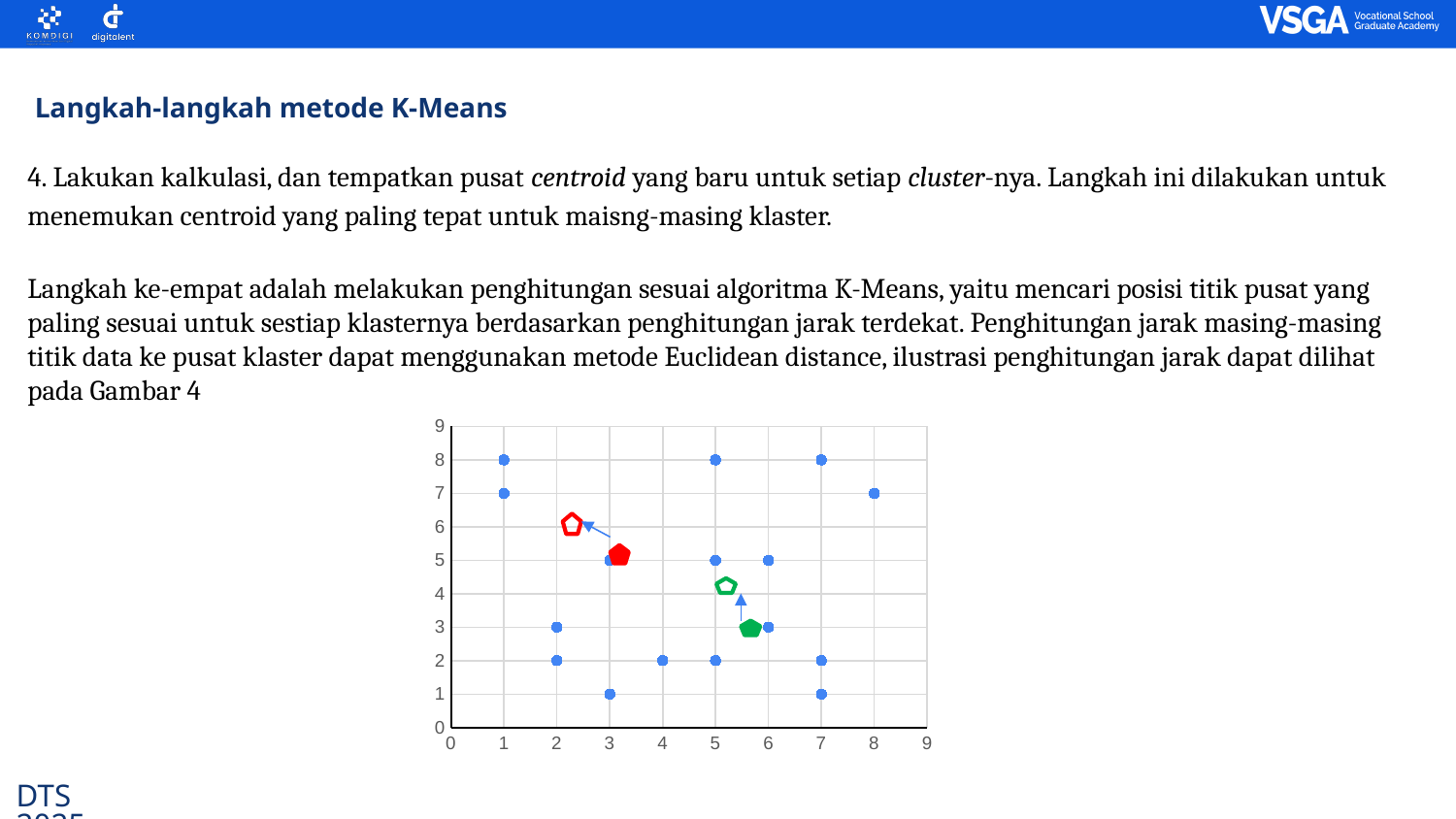
How many blue data points are plotted on the chart? 16 What is the highest y-value reached by any blue data point? 8 What is the y-value of the blue data point at x = 8? 7 What is the y-value of the blue data point at x = 4? 2 What kind of chart is shown on the slide? scatter chart What is the lowest y-value of any blue data point? 1 How many blue data points lie at y = 8? 3 Is the y-value of the filled red pentagon greater or less than 4? greater How many blue data points lie at y = 2? 4 What two colours are used for the pentagon centroid markers on the chart? red and green What is the highest value shown on the vertical axis of the chart? 9 What is the largest x-value of any blue data point? 8